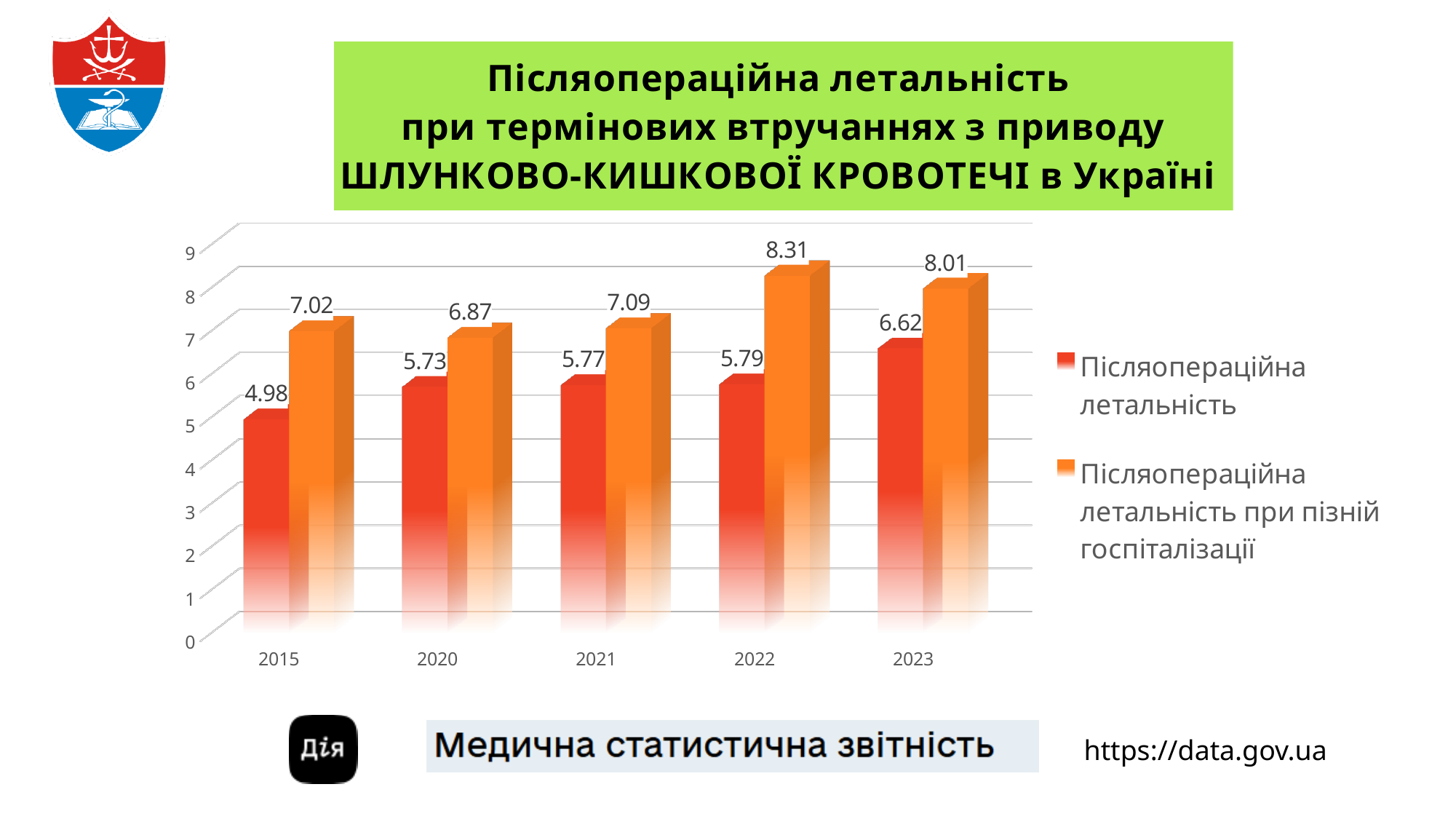
What is the difference between "Післяопераційна летальність при пізній госпіталізації" and "Післяопераційна летальність" in 2023? 1.39 What kind of chart is shown on the slide? bar chart What colour are the bars for "Післяопераційна летальність при пізній госпіталізації"? orange What is the value of "Післяопераційна летальність при пізній госпіталізації" for 2022? 8.31 Does "Післяопераційна летальність" rise or fall from 2015 to 2023? rise In which year is "Післяопераційна летальність" lowest? 2015 Which is larger in 2020: "Післяопераційна летальність" or "Післяопераційна летальність при пізній госпіталізації"? Післяопераційна летальність при пізній госпіталізації How many series does the legend list? 2 How many years are shown on the x axis? 5 What is the value of "Післяопераційна летальність" for 2023? 6.62 In which year is "Післяопераційна летальність при пізній госпіталізації" highest? 2022 What is the value of "Післяопераційна летальність" for 2015? 4.98